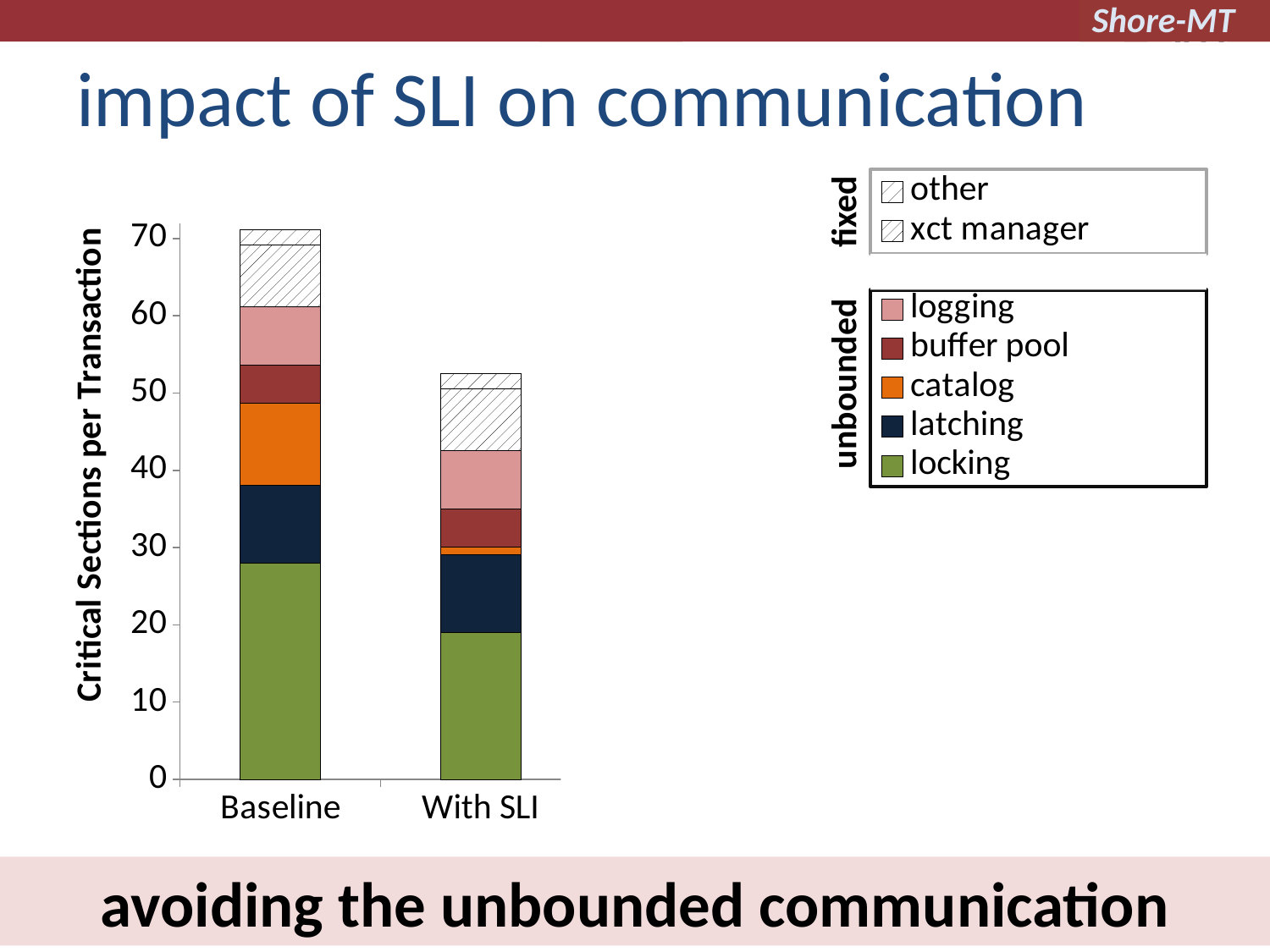
Which bar is taller, Baseline or With SLI? Baseline Is the total for the Baseline bar greater or less than 60? greater How many series do the legends list in total? 7 Which legend entries are grouped under the label 'fixed'? other, xct manager Do the bar totals rise or fall from Baseline to With SLI? fall What kind of chart is shown on the slide? stacked bar chart What is the title of the y axis? Critical Sections per Transaction Is the locking value for With SLI greater or less than 30? less How many categories are plotted on the x axis? 2 Is the locking value for Baseline greater or less than 20? greater Which category has the larger catalog segment, Baseline or With SLI? Baseline